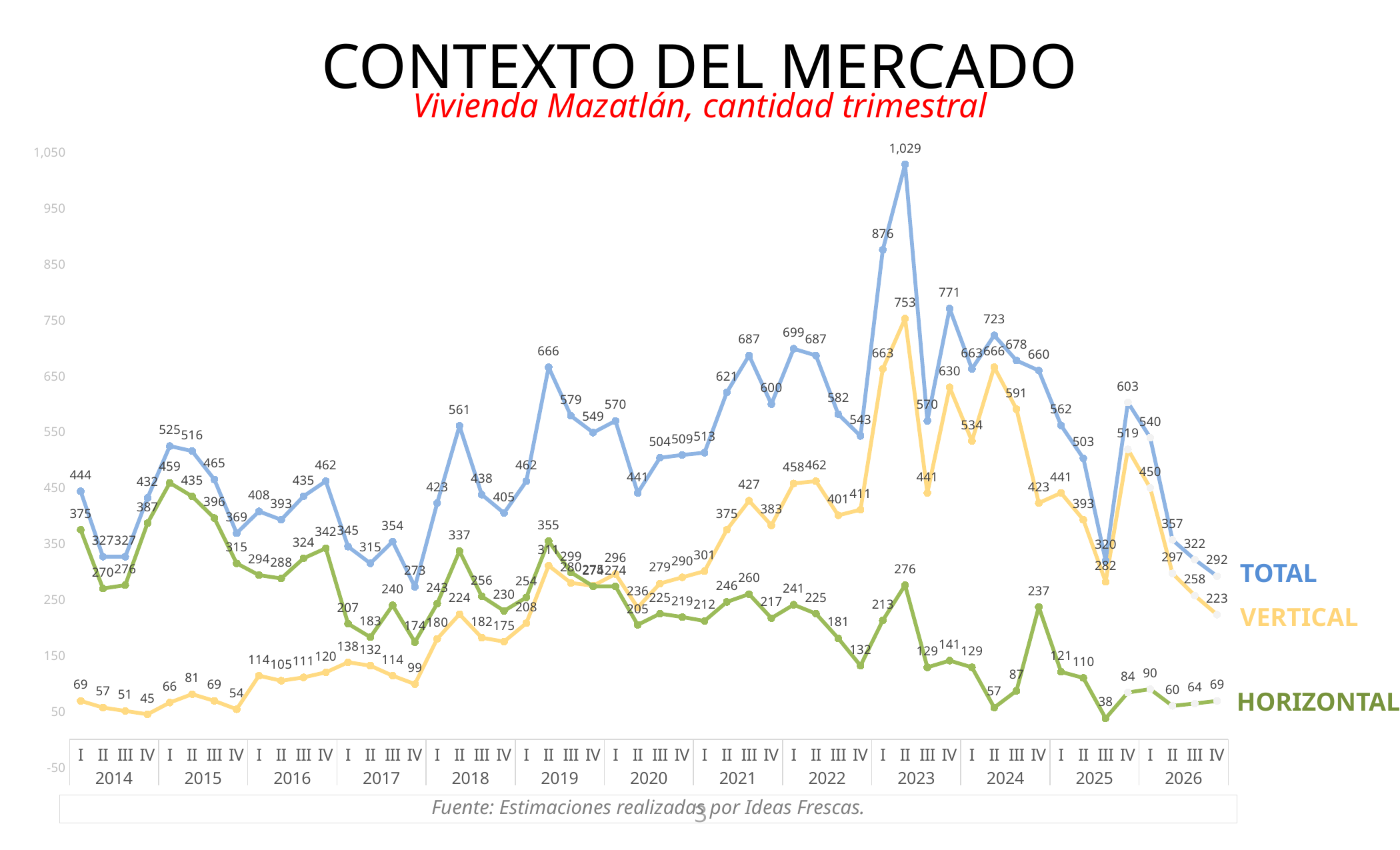
What is the highest value of the TOTAL series? 1,029 What is the VERTICAL value for quarter IV of 2026? 223 In quarter I of 2024, which is larger, VERTICAL or HORIZONTAL? VERTICAL What kind of chart is shown on the slide? line chart How many years are shown on the x axis? 13 Does the TOTAL series rise or fall from quarter IV of 2025 to quarter IV of 2026? fall How many series does the chart show? 3 In which quarter and year does the TOTAL series reach its highest value? II 2023 What is the TOTAL value for quarter I of 2014? 444 What is the difference between the TOTAL values for quarter II of 2023 and quarter I of 2023? 153 What is the HORIZONTAL value for quarter III of 2025? 38 What is the lowest value of the HORIZONTAL series? 38